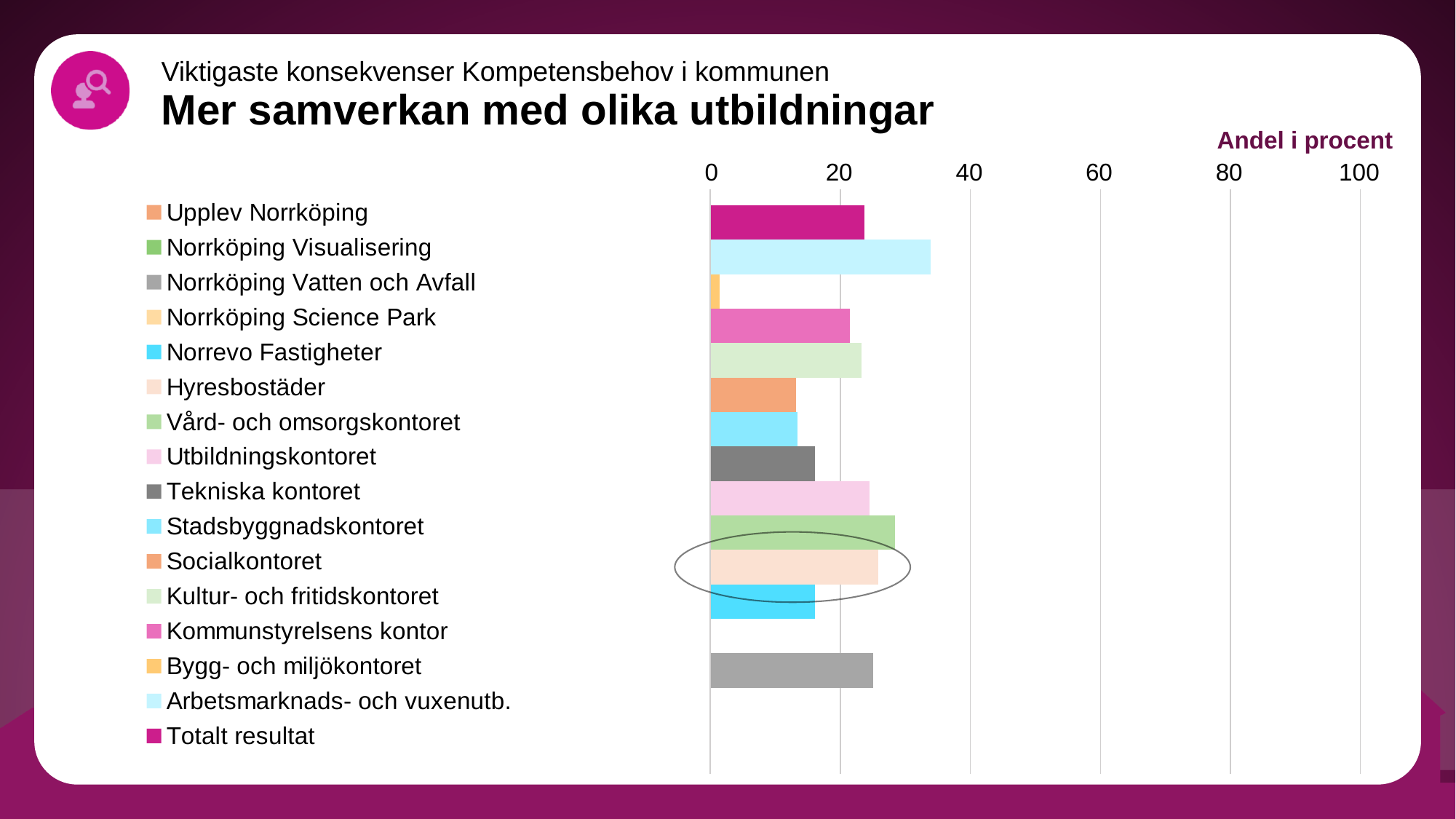
What kind of chart is shown on the slide? bar chart Is the value for Arbetsmarknads- och vuxenutb. greater or less than 20? greater What is the highest tick value shown on the horizontal axis? 100 Is the value for Bygg- och miljökontoret greater or less than 20? less Which category has the highest value in the chart? Arbetsmarknads- och vuxenutb. How many entries does the legend list? 16 What label is shown above the horizontal axis of the chart? Andel i procent Is the value for Arbetsmarknads- och vuxenutb. greater or less than 40? less Which is larger, the value for Vård- och omsorgskontoret or the value for Socialkontoret? Vård- och omsorgskontoret Which is larger, the value for Arbetsmarknads- och vuxenutb. or the value for Totalt resultat? Arbetsmarknads- och vuxenutb.